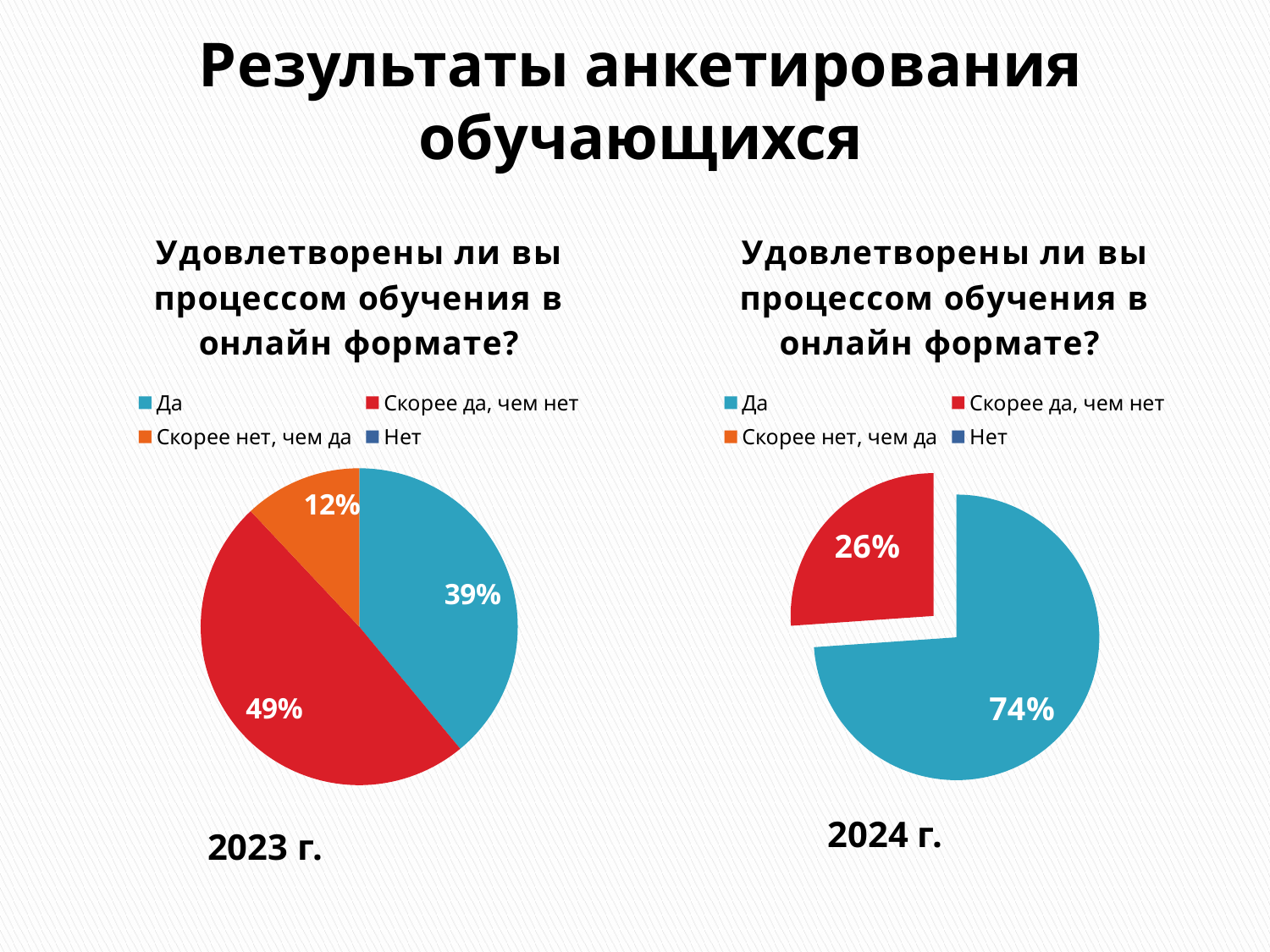
In the 2023 pie chart (left), what is the difference between the shares for "Скорее да, чем нет" and "Да"? 10% Which chart has the larger share for "Да": the 2023 chart (left) or the 2024 chart (right)? 2024 chart (right) In the 2023 pie chart (left), which labelled answer has the smallest share? Скорее нет, чем да In the 2023 pie chart (left), what share of respondents answered "Скорее да, чем нет"? 49% In the 2024 pie chart (right), which answer has the largest share? Да In the 2024 pie chart (right), what share of respondents answered "Скорее да, чем нет"? 26% In the 2024 pie chart (right), what share of respondents answered "Да"? 74% In the 2023 pie chart (left), which answer has the largest share? Скорее да, чем нет In the 2023 pie chart (left), what share of respondents answered "Скорее нет, чем да"? 12% How many entries does the legend of the 2023 pie chart (left) list? 4 In the 2023 pie chart (left), what share of respondents answered "Да"? 39% In the 2024 pie chart (right), what is the difference between the shares for "Да" and "Скорее да, чем нет"? 48%